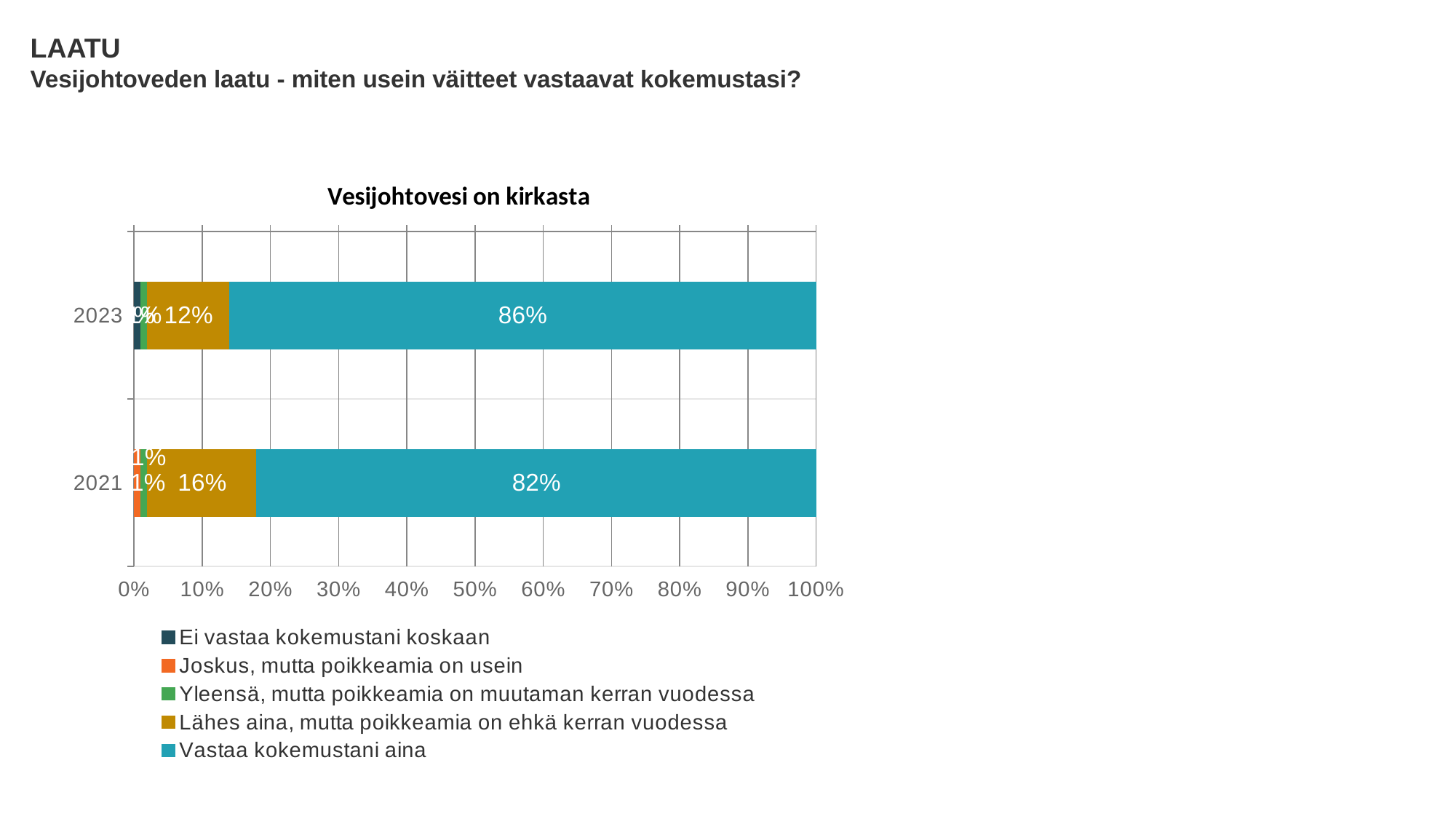
What is the difference between the "Vastaa kokemustani aina" values for 2023 and 2021? 4% How many series does the legend list? 5 What is the value for "Vastaa kokemustani aina" in 2023? 86% How many years (categories) are shown on the chart? 2 What is the value for "Lähes aina, mutta poikkeamia on ehkä kerran vuodessa" in 2021? 16% Which year has the higher value for "Vastaa kokemustani aina", 2023 or 2021? 2023 What is the value for "Lähes aina, mutta poikkeamia on ehkä kerran vuodessa" in 2023? 12% What is the value for "Vastaa kokemustani aina" in 2021? 82% Is the value for "Vastaa kokemustani aina" in 2021 greater or less than 80%? greater What kind of chart is shown on the slide? stacked bar chart What is the title of the chart? Vesijohtovesi on kirkasta What is the difference between the "Lähes aina, mutta poikkeamia on ehkä kerran vuodessa" values for 2021 and 2023? 4%